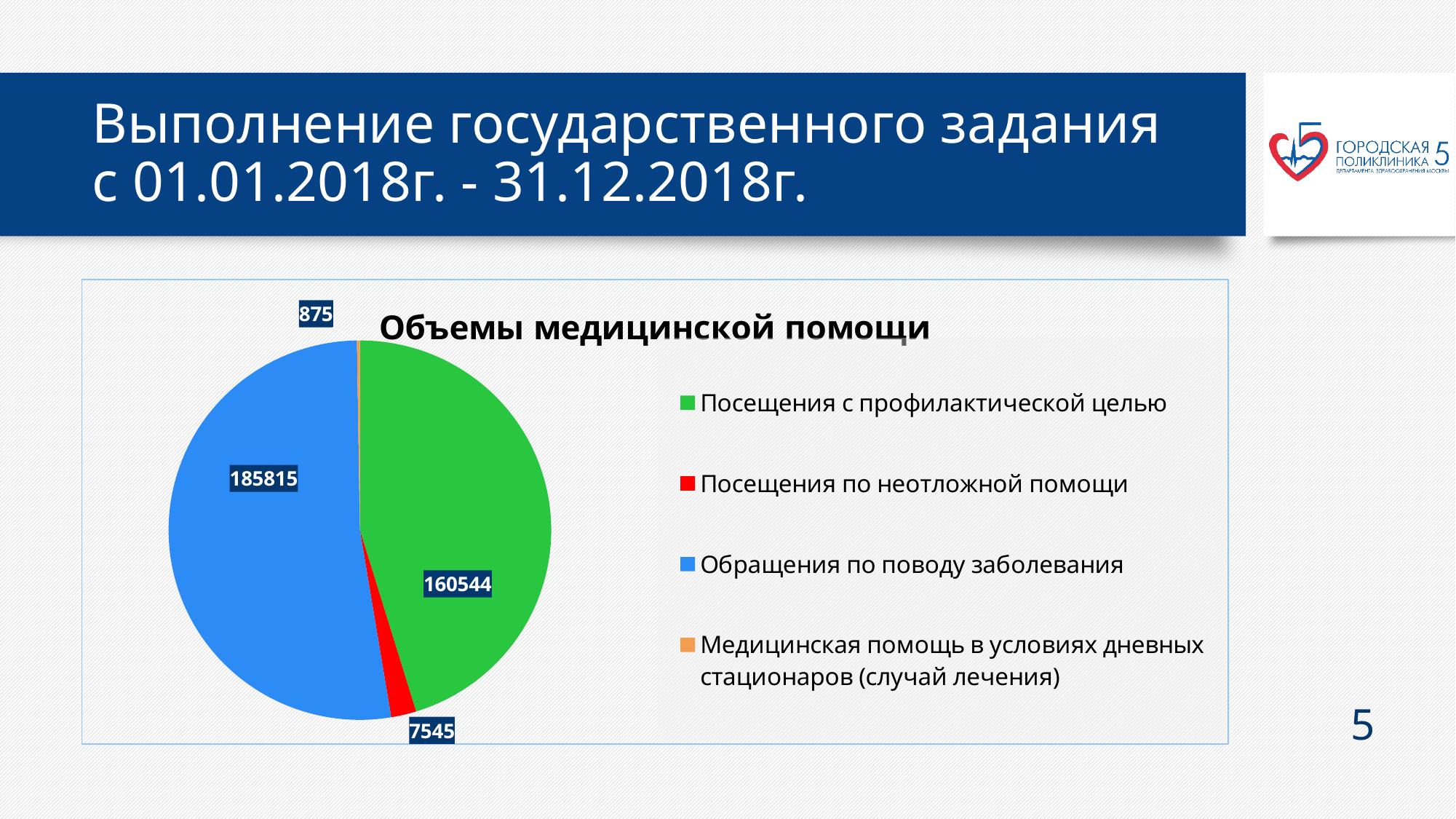
What is the value for 'Медицинская помощь в условиях дневных стационаров (случай лечения)'? 875 Which category has the smallest slice of the pie? Медицинская помощь в условиях дневных стационаров (случай лечения) Which is larger: 'Посещения по неотложной помощи' or 'Медицинская помощь в условиях дневных стационаров (случай лечения)'? Посещения по неотложной помощи What kind of chart is shown on the slide? Pie chart What colour represents 'Посещения по неотложной помощи' in the pie chart? Red Which category has the largest slice of the pie? Обращения по поводу заболевания What is the difference between the values for 'Обращения по поводу заболевания' and 'Посещения с профилактической целью'? 25271 What is the value for 'Обращения по поводу заболевания'? 185815 What is the value for 'Посещения с профилактической целью'? 160544 How many categories does the legend of the pie chart list? 4 What is the value for 'Посещения по неотложной помощи'? 7545 What is the title of the chart? Объемы медицинской помощи